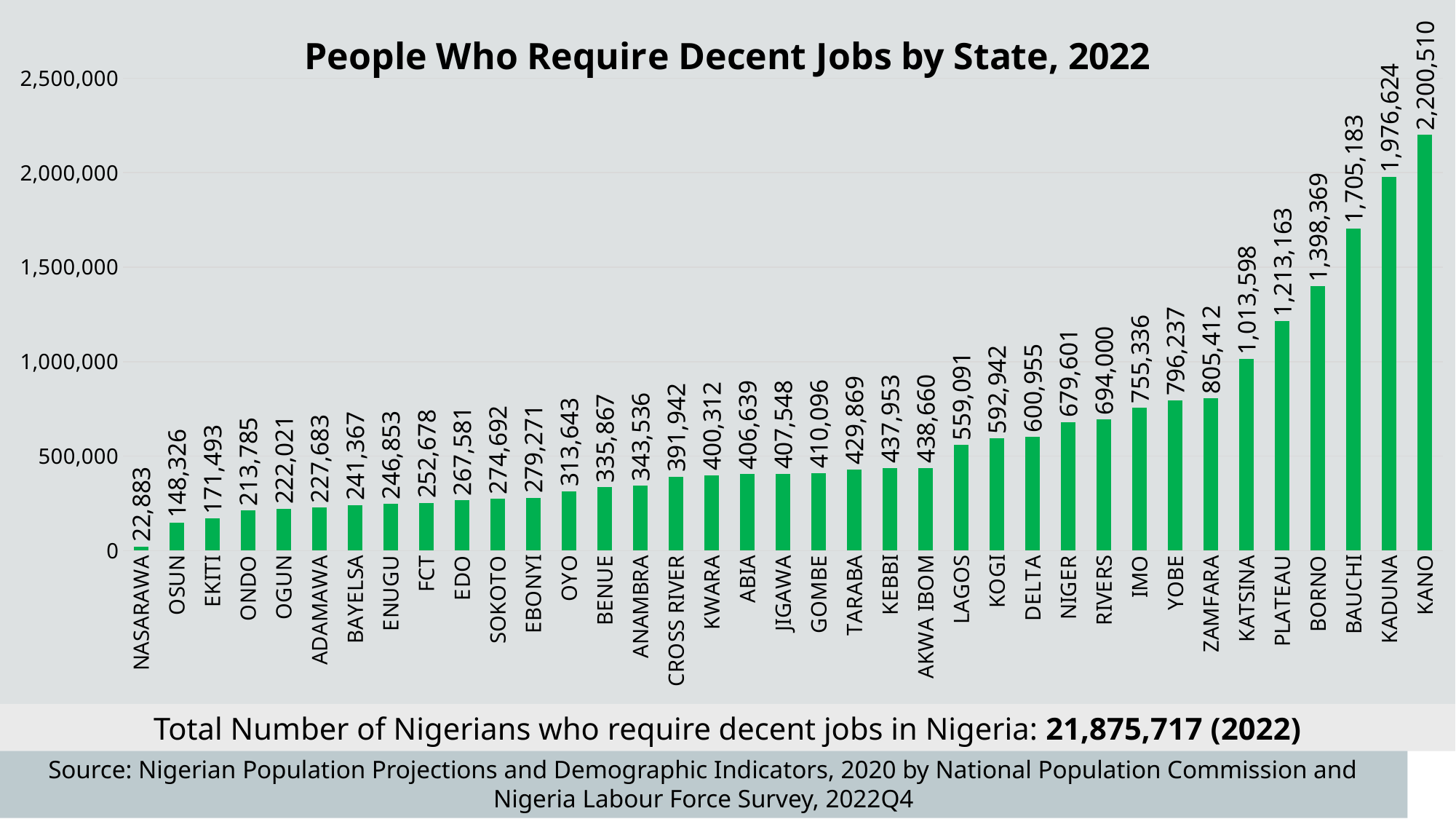
What is the title of the chart? People Who Require Decent Jobs by State, 2022 What is the value for Lagos? 559,091 How many states are shown on the chart? 37 What is the value for Kaduna? 1,976,624 What is the value for FCT? 252,678 What is the difference between the values for Kano and Kaduna? 223,886 Which state has the lowest number of people who require decent jobs? Nasarawa Is the value for Plateau greater or less than 1,000,000? greater Which state has the highest number of people who require decent jobs? Kano Which has a larger value, Katsina or Zamfara? Katsina What is the difference between the values for Bauchi and Borno? 306,814 What kind of chart is shown on the slide? bar chart